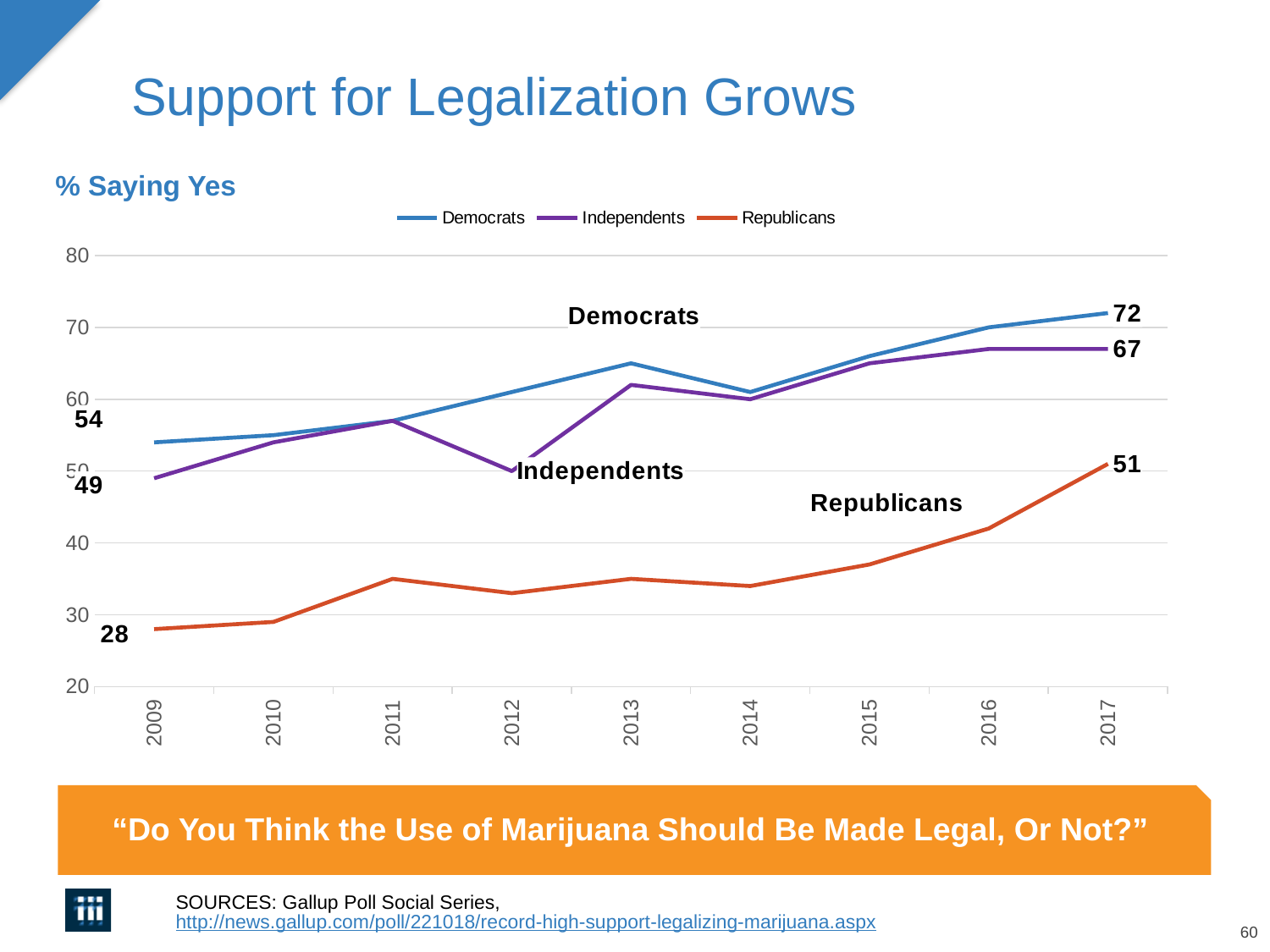
How many years are shown on the x axis? 9 What kind of chart is shown on the slide? line chart Which series has the lowest value in 2009? Republicans How many series does the legend list? 3 Is the value for Republicans in 2013 greater or less than 40? less Which series has the highest value in 2017? Democrats What is the difference between the Democrats and Independents values in 2017? 5 What is the value for Republicans in 2009? 28 What is the value for Democrats in 2017? 72 By how much did the Republicans value increase from 2009 to 2017? 23 What is the value for Independents in 2017? 67 What is the value for Independents in 2009? 49